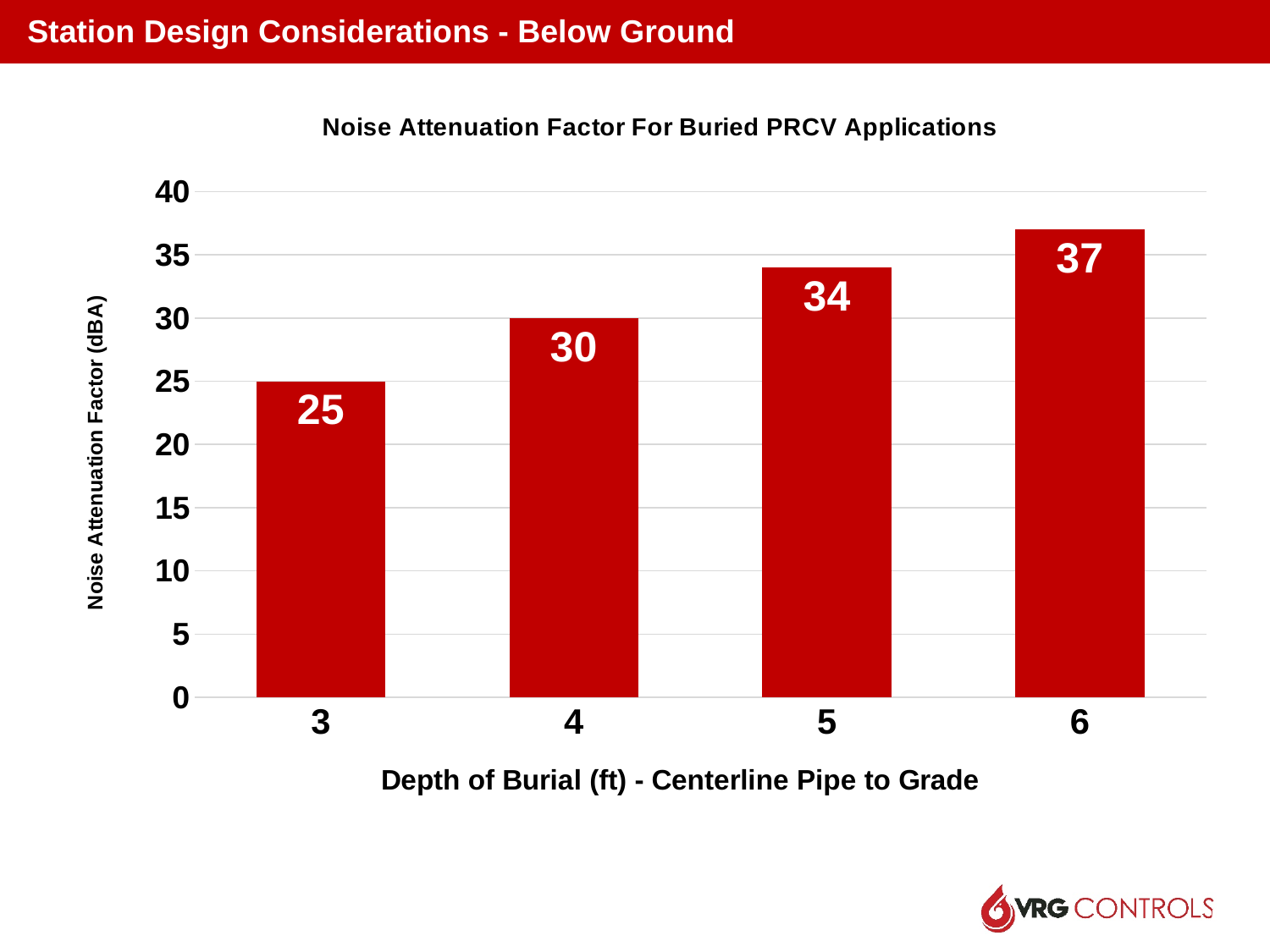
What is the difference in noise attenuation factor between a 6 ft and a 3 ft depth of burial? 12 What is the difference in noise attenuation factor between a 5 ft and a 4 ft depth of burial? 4 How many depth of burial categories are shown in the chart? 4 What is the noise attenuation factor at a depth of burial of 5 ft? 34 What is the noise attenuation factor at a depth of burial of 6 ft? 37 What is the noise attenuation factor at a depth of burial of 3 ft? 25 Does the noise attenuation factor rise or fall as the depth of burial increases? Rises Which depth of burial has the lowest noise attenuation factor? 3 What kind of chart is shown on the slide? Bar chart Is the noise attenuation factor at 4 ft depth of burial greater or less than 35? less Which depth of burial has the highest noise attenuation factor? 6 Which has a larger noise attenuation factor, a 4 ft or a 5 ft depth of burial? 5 ft